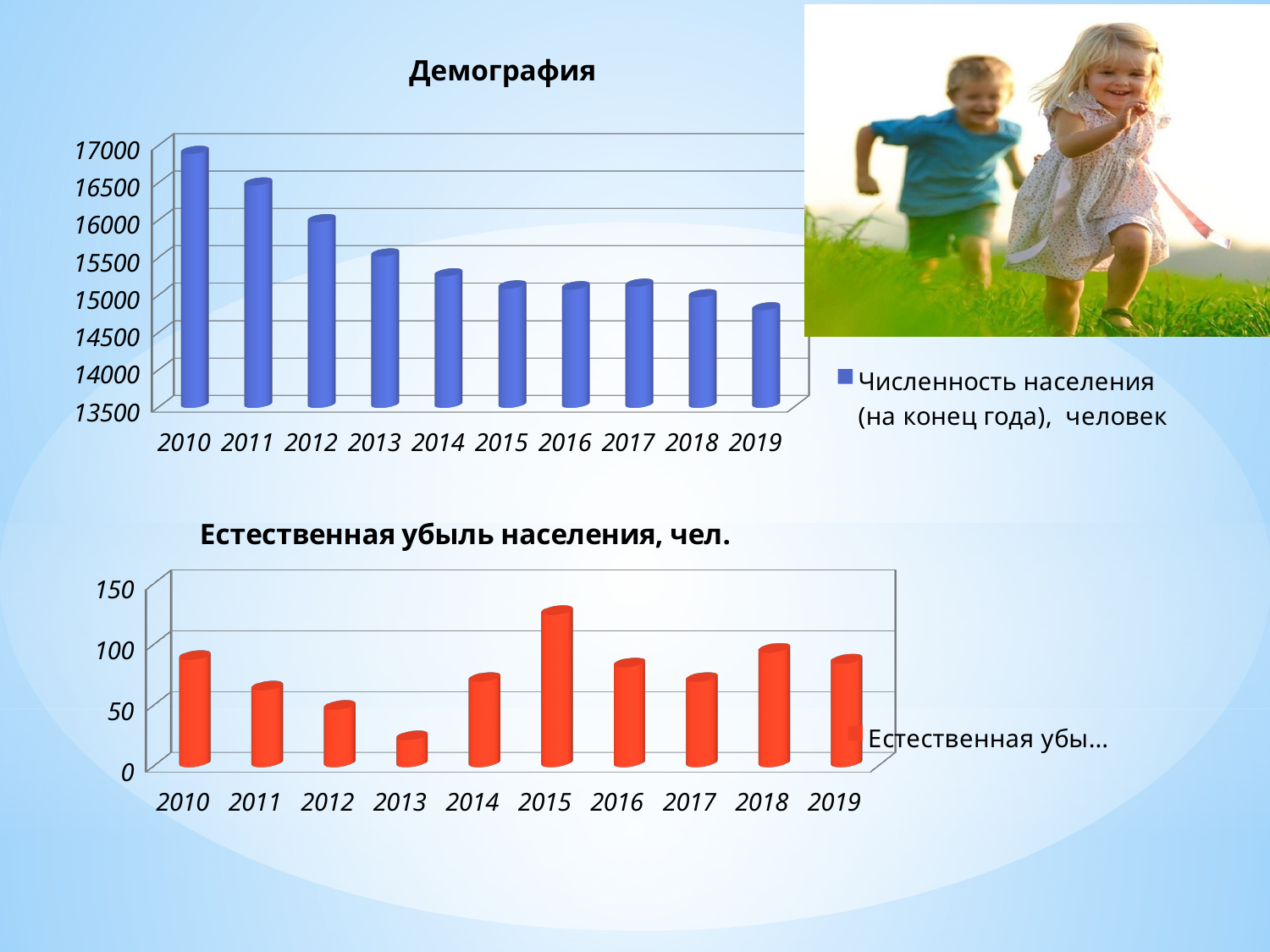
On the chart titled "Демография", is the value for 2010 greater or less than 16500? greater What kind of chart is the one titled "Естественная убыль населения, чел."? bar chart On the chart titled "Демография", which year has the lowest population? 2019 On the chart titled "Демография", how many years are shown on the x axis? 10 On the chart titled "Естественная убыль населения, чел.", which year has the highest value? 2015 On the chart titled "Демография", which is larger, the value for 2012 or the value for 2014? 2012 On the chart titled "Демография", do the values generally rise or fall from 2010 to 2019? fall On the chart titled "Демография", which year has the highest population? 2010 On the chart titled "Естественная убыль населения, чел.", which year has the lowest value? 2013 On the chart titled "Демография", what is the legend entry for the series? Численность населения (на конец года), человек On the chart titled "Демография", is the value for 2019 greater or less than 15000? less On the chart titled "Естественная убыль населения, чел.", is the value for 2015 greater or less than 100? greater